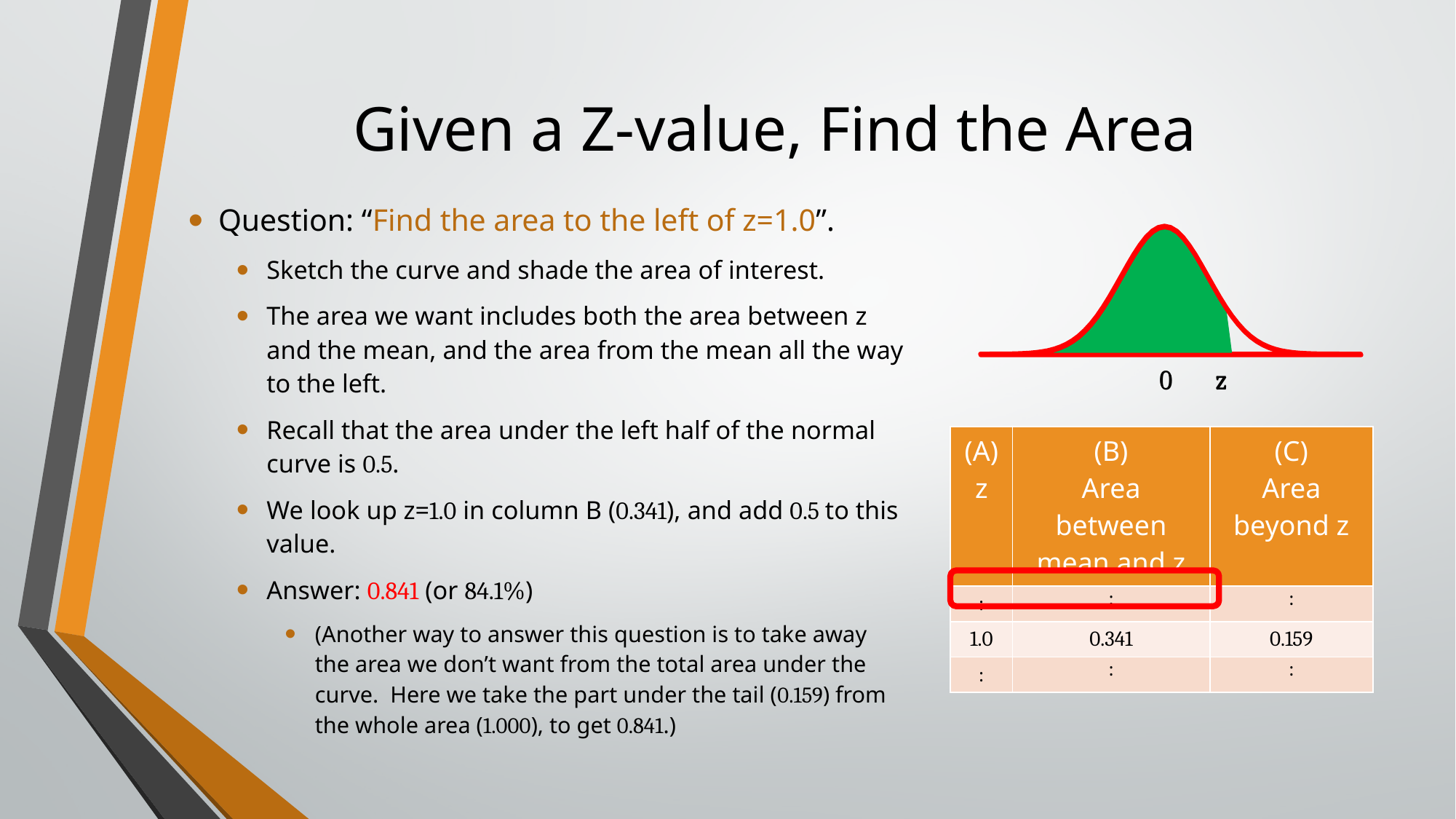
In the table, what is the difference between the area between the mean and z (0.341) and the area beyond z (0.159) for z = 1.0? 0.182 What two labels appear beneath the horizontal axis of the normal curve sketch? 0 and z In the table, which is larger for z = 1.0: the area between the mean and z, or the area beyond z? Area between mean and z In the table, what is the area beyond z for z = 1.0? 0.159 How many labelled columns does the table on the slide have? 3 What colour is the shaded area under the normal curve on the slide? Green Is the shaded region of the normal curve to the left or to the right of z? Left In the table, what is the area between the mean and z for z = 1.0? 0.341